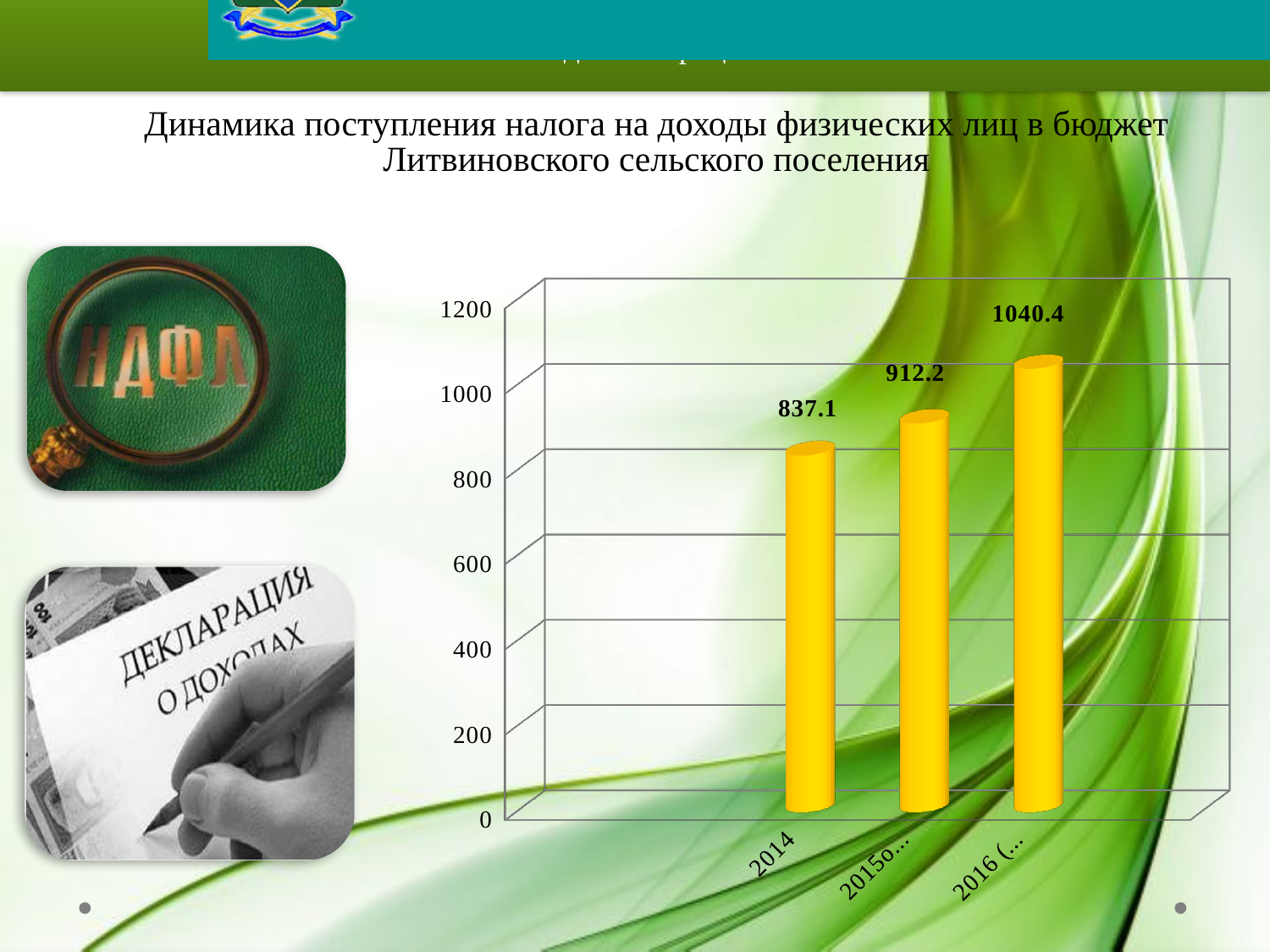
How many bars are shown in the chart? 3 What is the value shown for the 2015 bar? 912.2 What is the value shown for the 2016 bar? 1040.4 Which is larger, the value for 2015 or the value for 2014? 2015 Do the values rise or fall from 2014 to 2016? rise Is the value for 2016 greater or less than 1000? greater What is the difference between the 2016 value and the 2014 value? 203.3 What is the value shown for 2014? 837.1 What is the difference between the 2015 value and the 2014 value? 75.1 Which year has the lowest value? 2014 What kind of chart is shown on the slide? bar chart Which year has the highest value? 2016